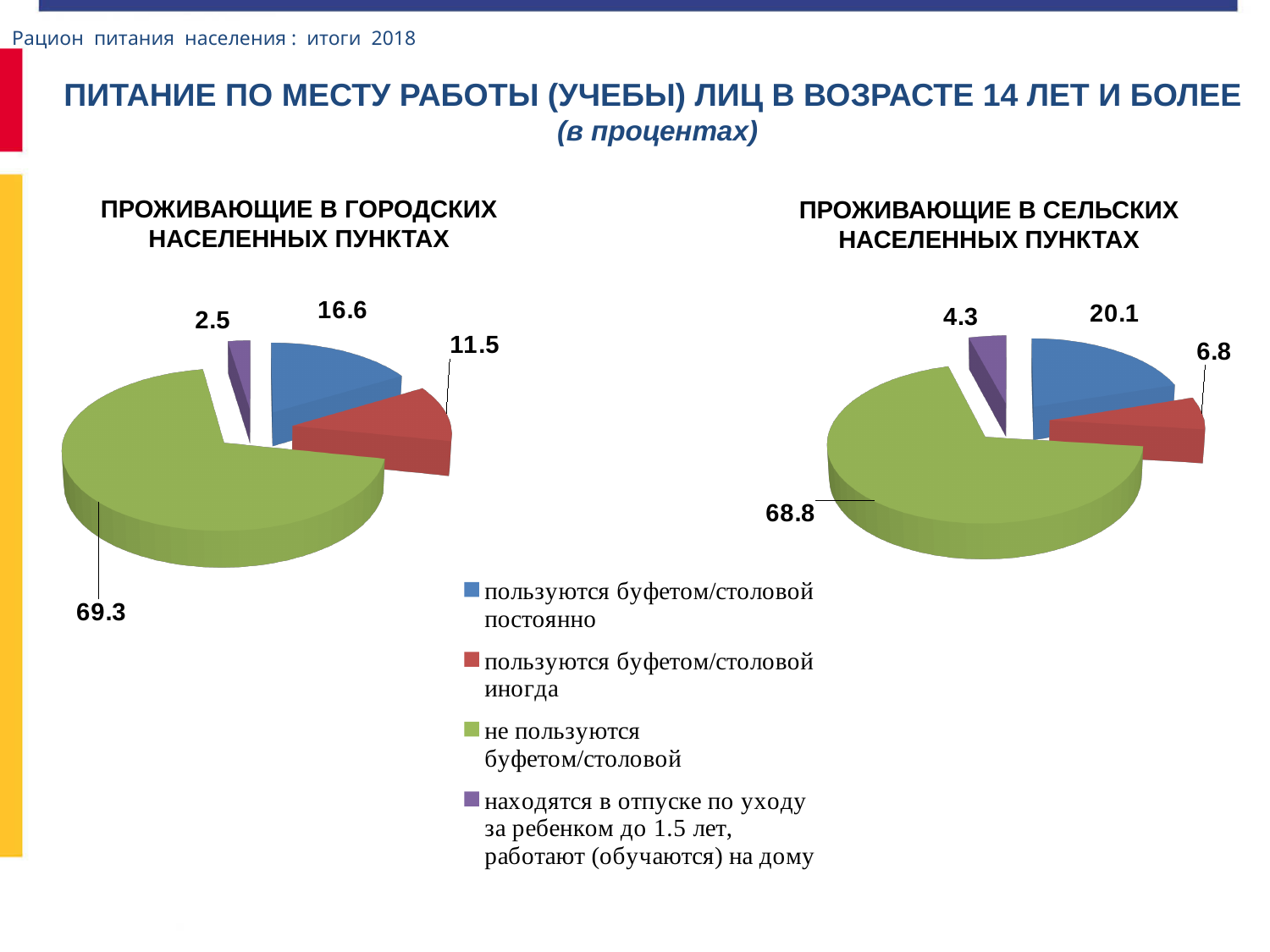
How many slices does the left chart (ПРОЖИВАЮЩИЕ В ГОРОДСКИХ НАСЕЛЕННЫХ ПУНКТАХ) have? 4 What colour is the slice for 'не пользуются буфетом/столовой'? green On the right chart (ПРОЖИВАЮЩИЕ В СЕЛЬСКИХ НАСЕЛЕННЫХ ПУНКТАХ), what is the difference between 'пользуются буфетом/столовой постоянно' and 'пользуются буфетом/столовой иногда'? 13.3 On the right chart (ПРОЖИВАЮЩИЕ В СЕЛЬСКИХ НАСЕЛЕННЫХ ПУНКТАХ), what is the value for 'пользуются буфетом/столовой постоянно'? 20.1 On the right chart (ПРОЖИВАЮЩИЕ В СЕЛЬСКИХ НАСЕЛЕННЫХ ПУНКТАХ), which category has the largest slice? не пользуются буфетом/столовой On the right chart (ПРОЖИВАЮЩИЕ В СЕЛЬСКИХ НАСЕЛЕННЫХ ПУНКТАХ), what is the value for 'находятся в отпуске по уходу за ребенком до 1.5 лет, работают (обучаются) на дому'? 4.3 On the left chart (ПРОЖИВАЮЩИЕ В ГОРОДСКИХ НАСЕЛЕННЫХ ПУНКТАХ), what is the value for 'не пользуются буфетом/столовой'? 69.3 What type of chart is used on this slide? pie chart On the left chart (ПРОЖИВАЮЩИЕ В ГОРОДСКИХ НАСЕЛЕННЫХ ПУНКТАХ), what is the value for 'пользуются буфетом/столовой иногда'? 11.5 On the left chart (ПРОЖИВАЮЩИЕ В ГОРОДСКИХ НАСЕЛЕННЫХ ПУНКТАХ), which category has the smallest slice? находятся в отпуске по уходу за ребенком до 1.5 лет, работают (обучаются) на дому Which chart has the larger value for 'пользуются буфетом/столовой иногда', the left (городских) or the right (сельских)? the left chart (городских) How many entries does the legend list? 4